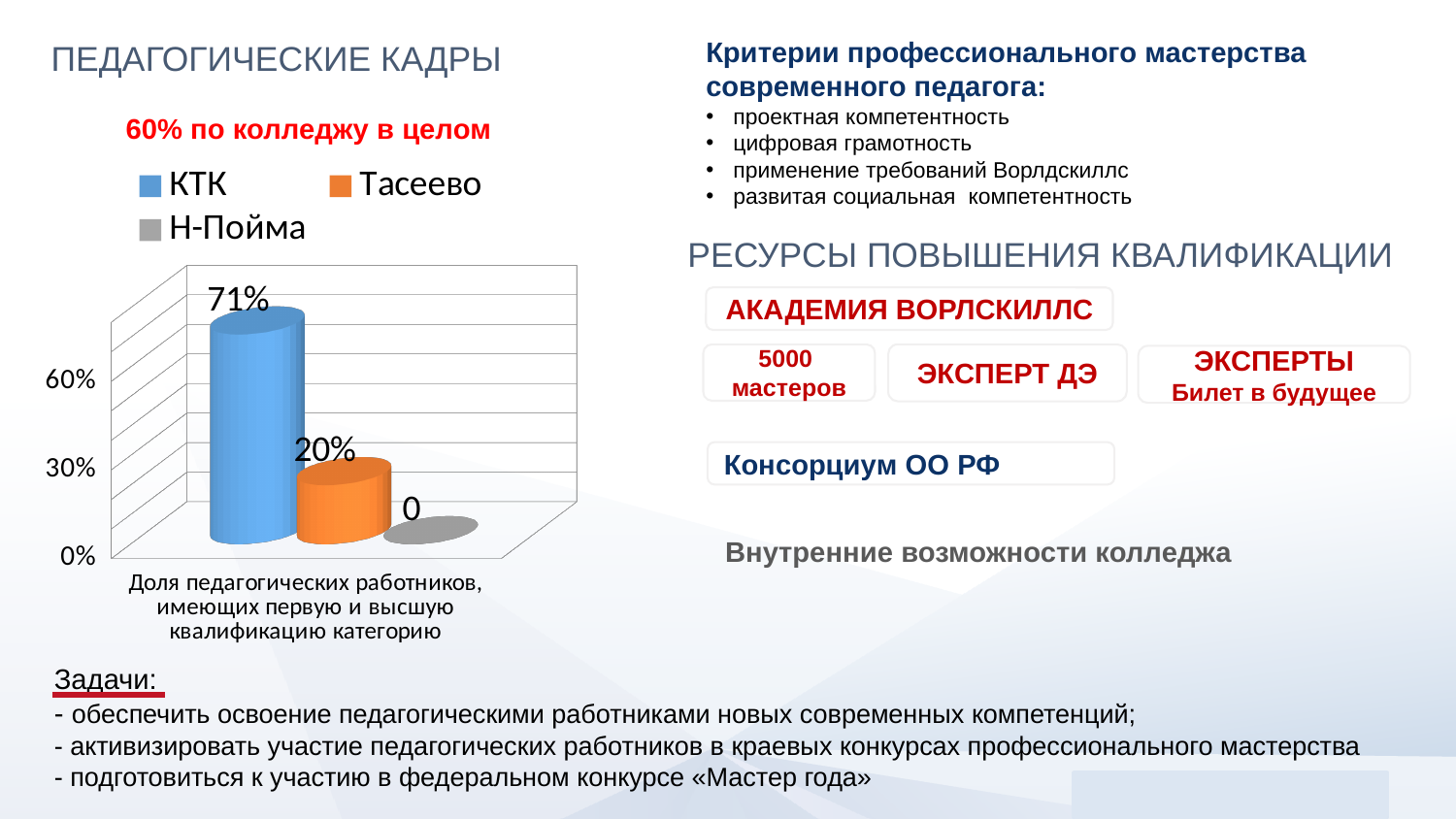
Which is larger, the value for КТК or the value for Тасеево? КТК What value is shown for КТК in the chart? 71% Is the value for КТК greater or less than 60%? greater How many series does the chart legend list? 3 What value is shown for Тасеево in the chart? 20% Which series has the lowest value in the chart? Н-Пойма What kind of chart is shown on the slide? bar chart Is the value for Тасеево greater or less than 30%? less Which series has the highest value in the chart? КТК What value is shown for Н-Пойма in the chart? 0 What is the difference between the values for КТК and Тасеево? 51% What colour is the bar for Тасеево in the chart? orange